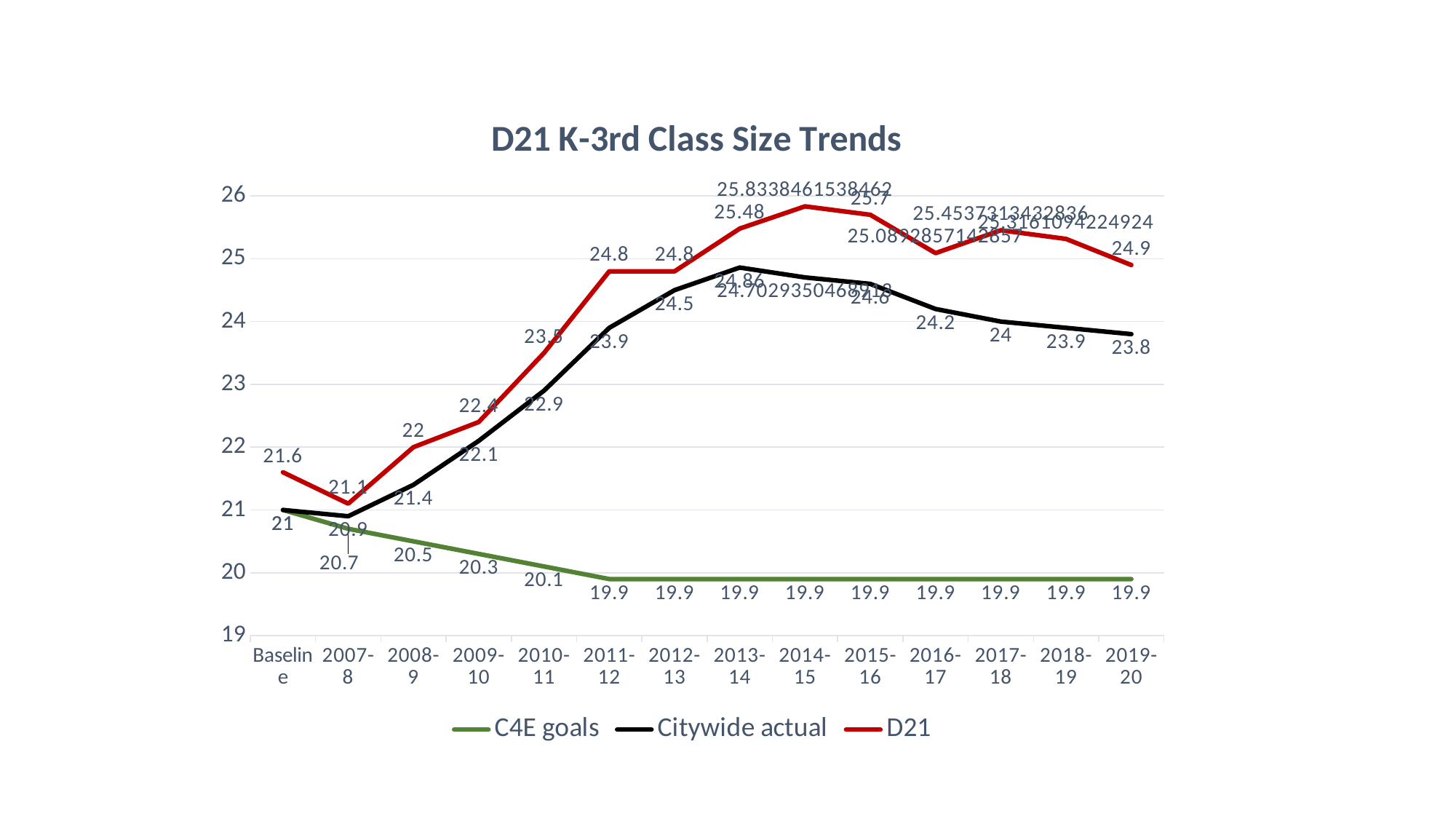
In which year does the D21 series reach its highest value? 2014-15 What is the difference between the D21 and Citywide actual values for 2019-20? 1.1 Which is larger in 2012-13, the D21 value or the Citywide actual value? D21 How many categories are shown on the x axis? 14 In which year does the Citywide actual series reach its highest value? 2013-14 How many series does the legend list? 3 What is the C4E goals value for 2009-10? 20.3 Is the D21 value for 2014-15 greater or less than 25? greater What is the D21 value for 2013-14? 25.48 What is the Citywide actual value for 2012-13? 24.5 What type of chart is shown on the slide? Line chart What is the D21 value at Baseline? 21.6